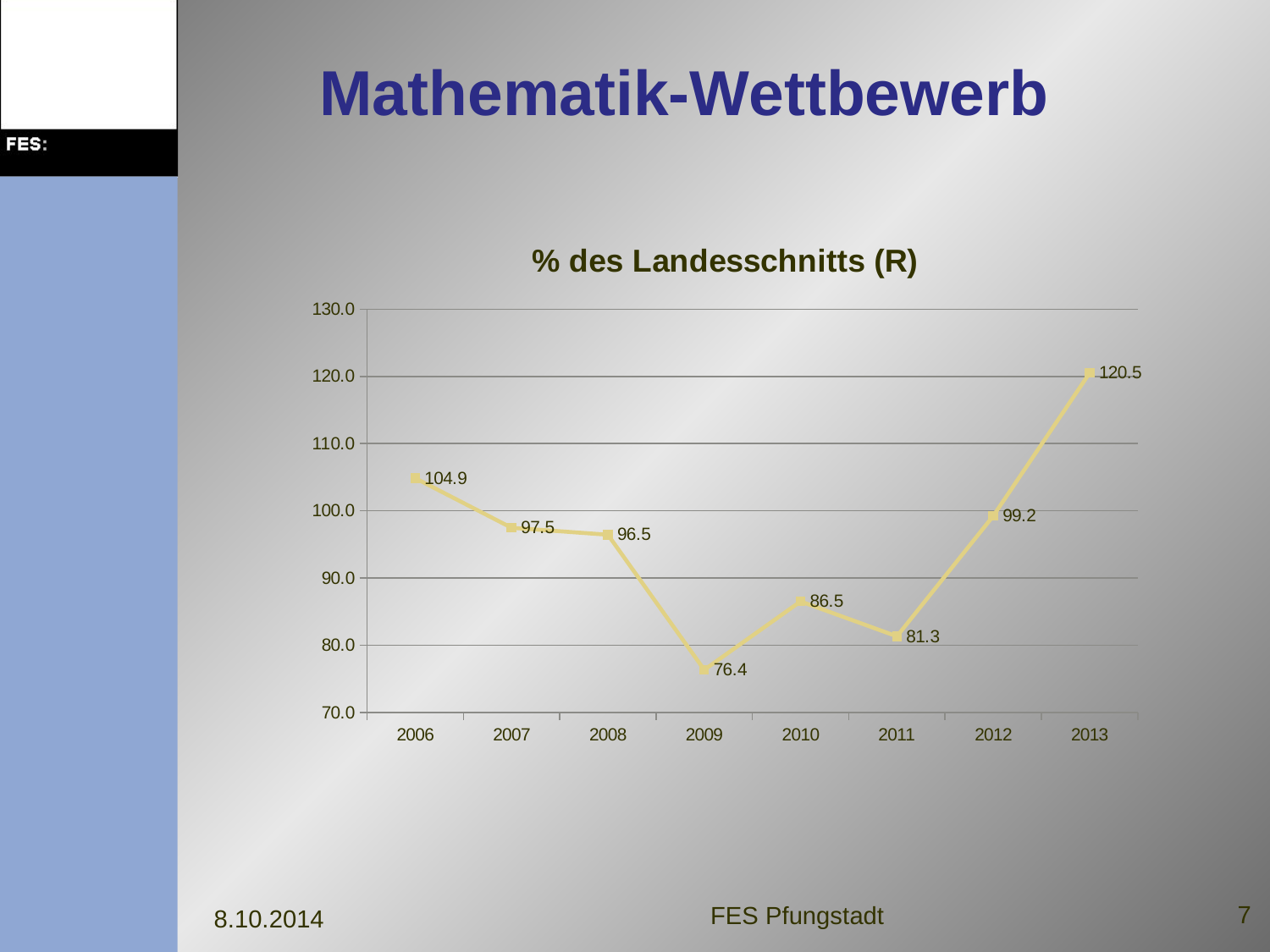
How many years are plotted on the chart? 8 Is the value for 2008 greater or less than 100? less What is the difference between the values for 2006 and 2009? 28.5 What is the difference between the values for 2013 and 2012? 21.3 Which is larger, the value for 2010 or the value for 2011? 2010 What is the value for 2006? 104.9 What is the value for 2009? 76.4 Which year has the highest value? 2013 What is the title of the chart? % des Landesschnitts (R) Which year has the lowest value? 2009 What is the value for 2012? 99.2 What kind of chart is shown? line chart